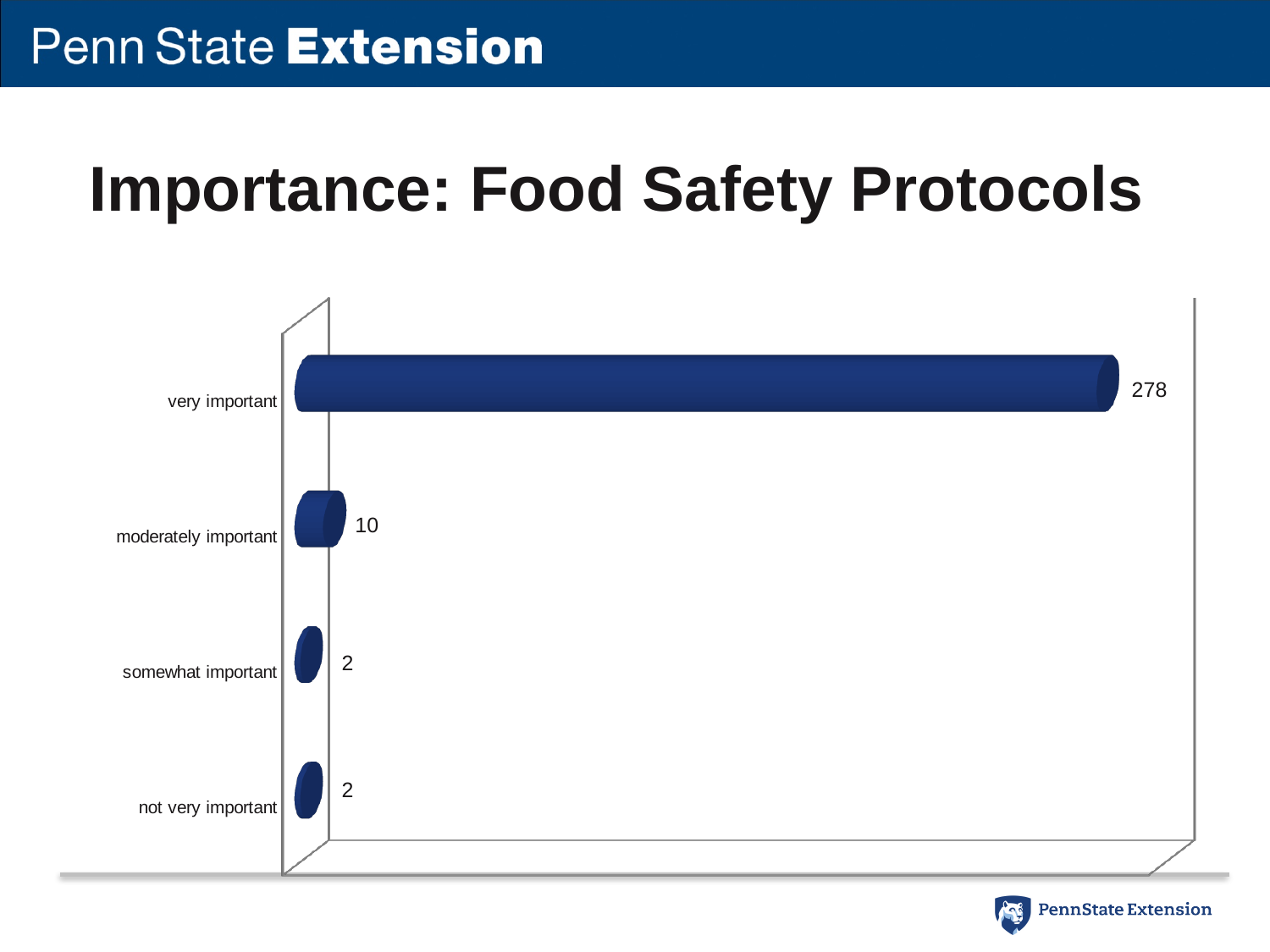
What kind of chart is shown on the slide? bar chart Which is larger, the value for "moderately important" or the value for "somewhat important"? moderately important Which category has the highest value? very important What is the value for "very important"? 278 How many categories are shown in the chart? 4 What is the title of the slide? Importance: Food Safety Protocols What is the value for "not very important"? 2 What is the difference between the values for "moderately important" and "somewhat important"? 8 What is the value for "somewhat important"? 2 What is the value for "moderately important"? 10 What colour are the bars in the chart? dark blue What is the difference between the values for "very important" and "moderately important"? 268